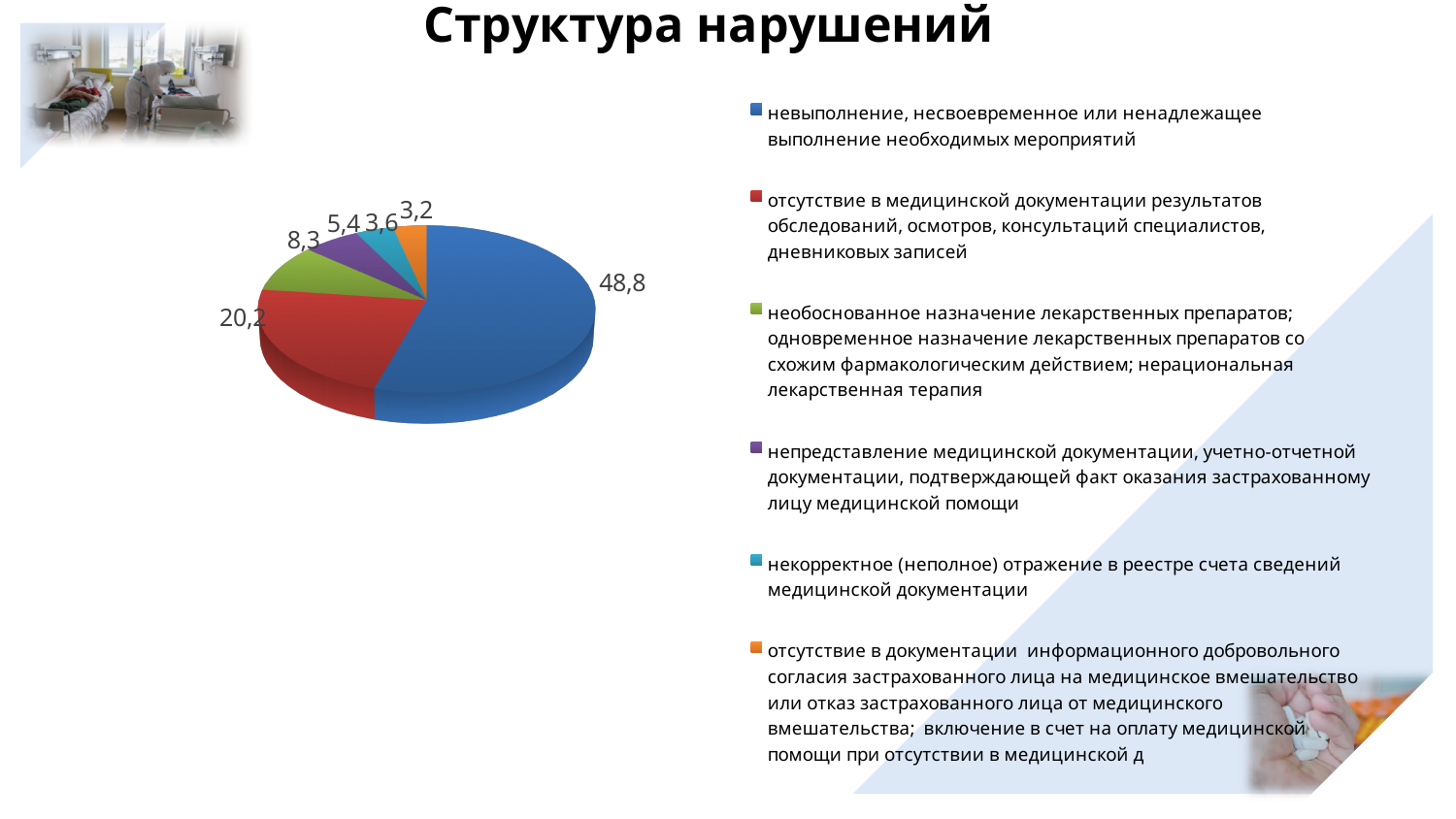
Какое значение указано для категории «непредставление медицинской документации, учетно-отчетной документации...»? 5,4 Какое значение указано для категории «необоснованное назначение лекарственных препаратов...»? 8,3 Сколько категорий показано на круговой диаграмме? 6 Какое значение указано для категории «невыполнение, несвоевременное или ненадлежащее выполнение необходимых мероприятий»? 48,8 Какое значение указано для категории «некорректное (неполное) отражение в реестре счета сведений медицинской документации»? 3,6 Какая категория имеет наименьшее значение на диаграмме? отсутствие в документации информационного добровольного согласия застрахованного лица на медицинское вмешательство... Какая категория имеет наибольшую долю на диаграмме? невыполнение, несвоевременное или ненадлежащее выполнение необходимых мероприятий Что больше: значение для «необоснованное назначение лекарственных препаратов...» или для «непредставление медицинской документации...»? необоснованное назначение лекарственных препаратов... Какой тип диаграммы показан на слайде «Структура нарушений»? круговая диаграмма Какое значение указано для категории «отсутствие в медицинской документации результатов обследований, осмотров, консультаций специалистов, дневниковых записей»? 20,2 Каким цветом на диаграмме обозначена категория «невыполнение, несвоевременное или ненадлежащее выполнение необходимых мероприятий»? синим На сколько значение категории «невыполнение, несвоевременное или ненадлежащее выполнение необходимых мероприятий» больше значения категории «отсутствие в медицинской документации результатов обследований...»? 28,6